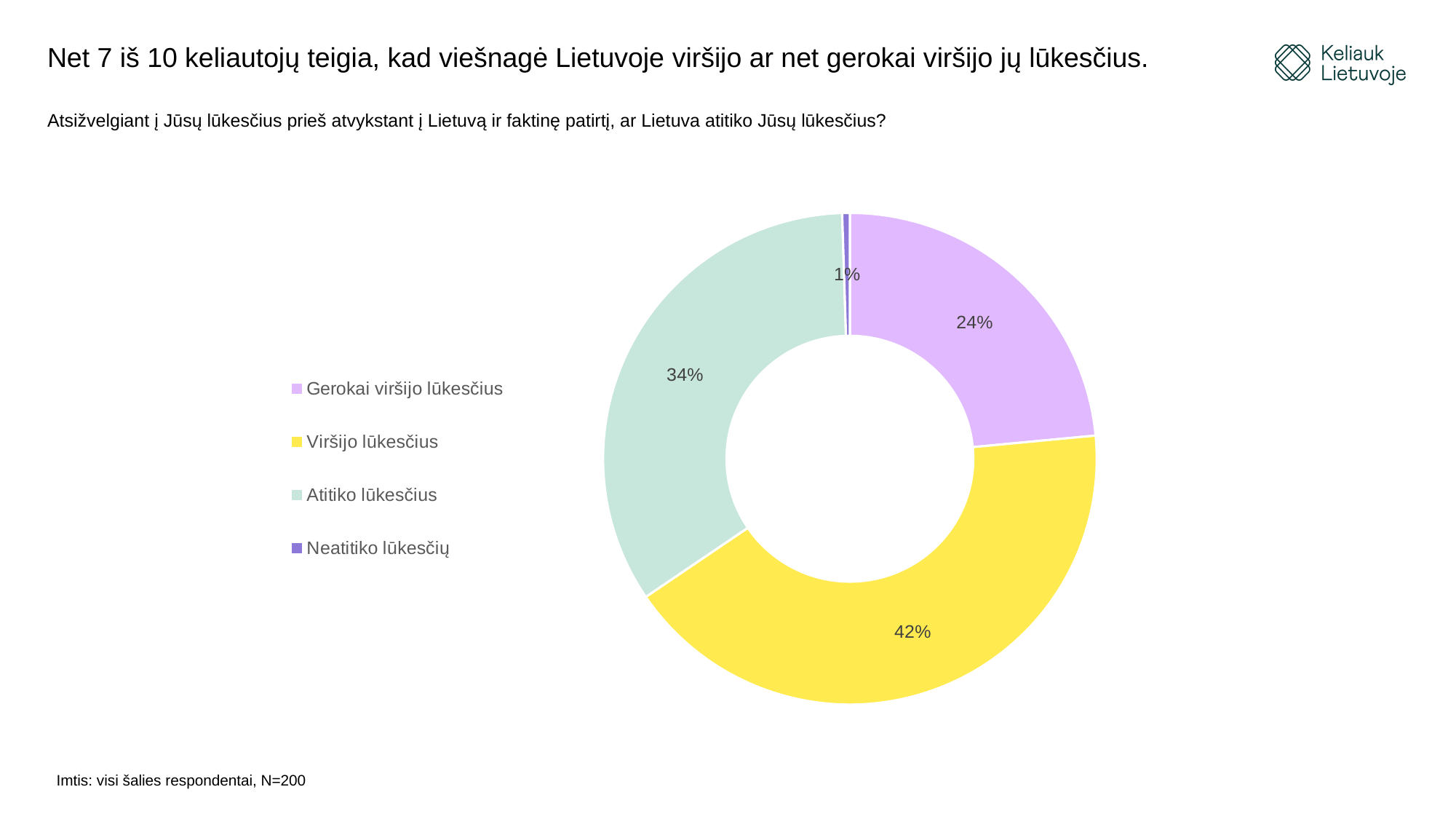
Which category has the largest share of the pie? Viršijo lūkesčius What is the sample size stated at the bottom of the slide? N=200 What share of respondents answered "Viršijo lūkesčius"? 42% Which is larger: the share for "Gerokai viršijo lūkesčius" or the share for "Atitiko lūkesčius"? Atitiko lūkesčius What share of respondents answered "Atitiko lūkesčius"? 34% What is the difference in percentage points between "Viršijo lūkesčius" and "Atitiko lūkesčius"? 8 percentage points Which category has the smallest share of the pie? Neatitiko lūkesčių What kind of chart is shown on the slide? Pie chart (donut) How many categories does the legend list? 4 What share of respondents answered "Gerokai viršijo lūkesčius"? 24% What colour represents "Atitiko lūkesčius" in the chart? Light green What share of respondents answered "Neatitiko lūkesčių"? 1%